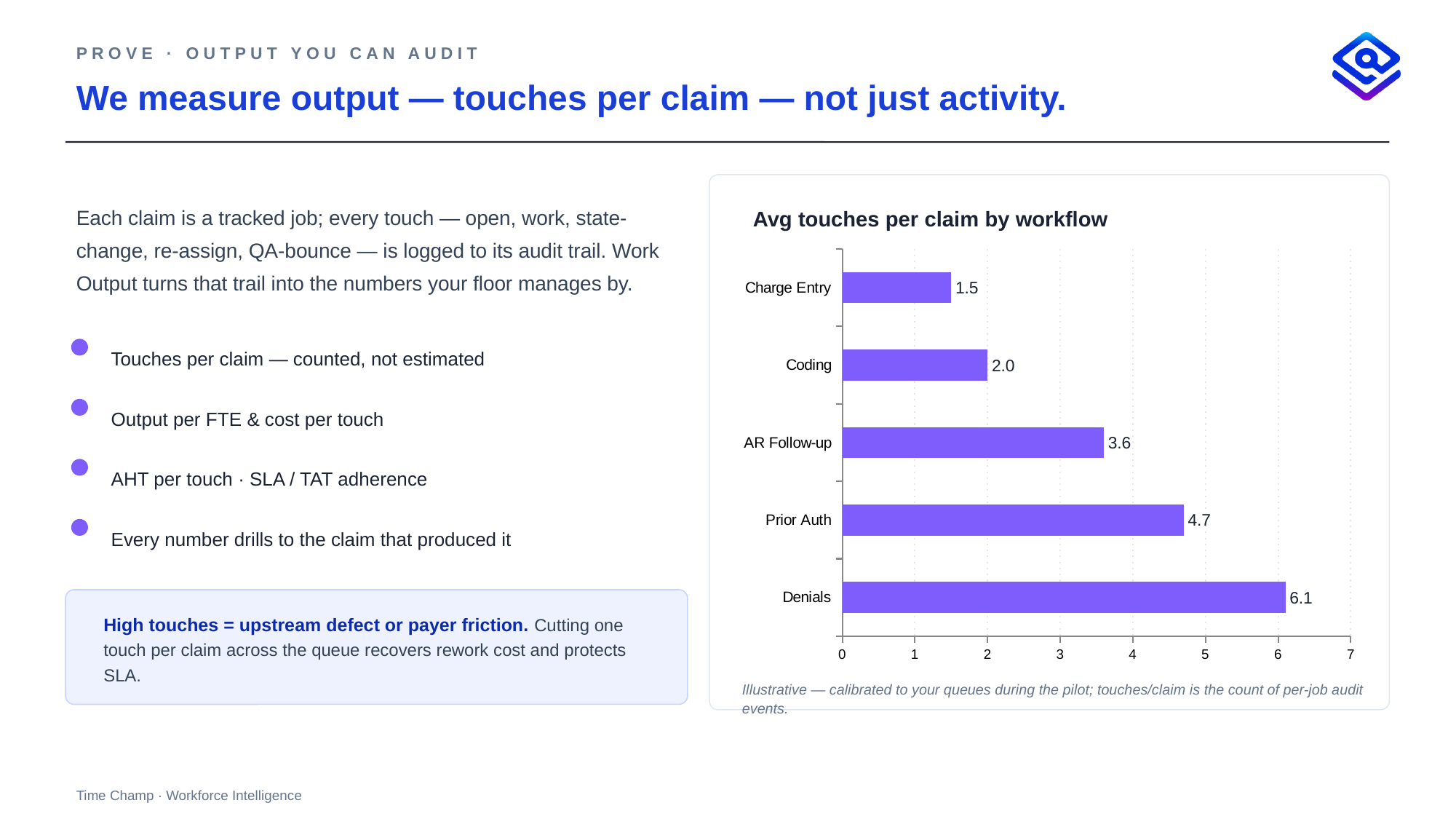
Which has more average touches per claim, Prior Auth or Coding? Prior Auth What is the average touches per claim for Denials? 6.1 Which workflow has the lowest average touches per claim? Charge Entry What is the average touches per claim for AR Follow-up? 3.6 What is the title of the chart? Avg touches per claim by workflow What is the difference in average touches per claim between Denials and Charge Entry? 4.6 How many workflows are shown in the chart? 5 What kind of chart is used to show average touches per claim by workflow? Bar chart Is the value for Denials greater or less than 5? greater What is the average touches per claim for Coding? 2.0 Which workflow has the highest average touches per claim? Denials What is the difference in average touches per claim between Prior Auth and AR Follow-up? 1.1